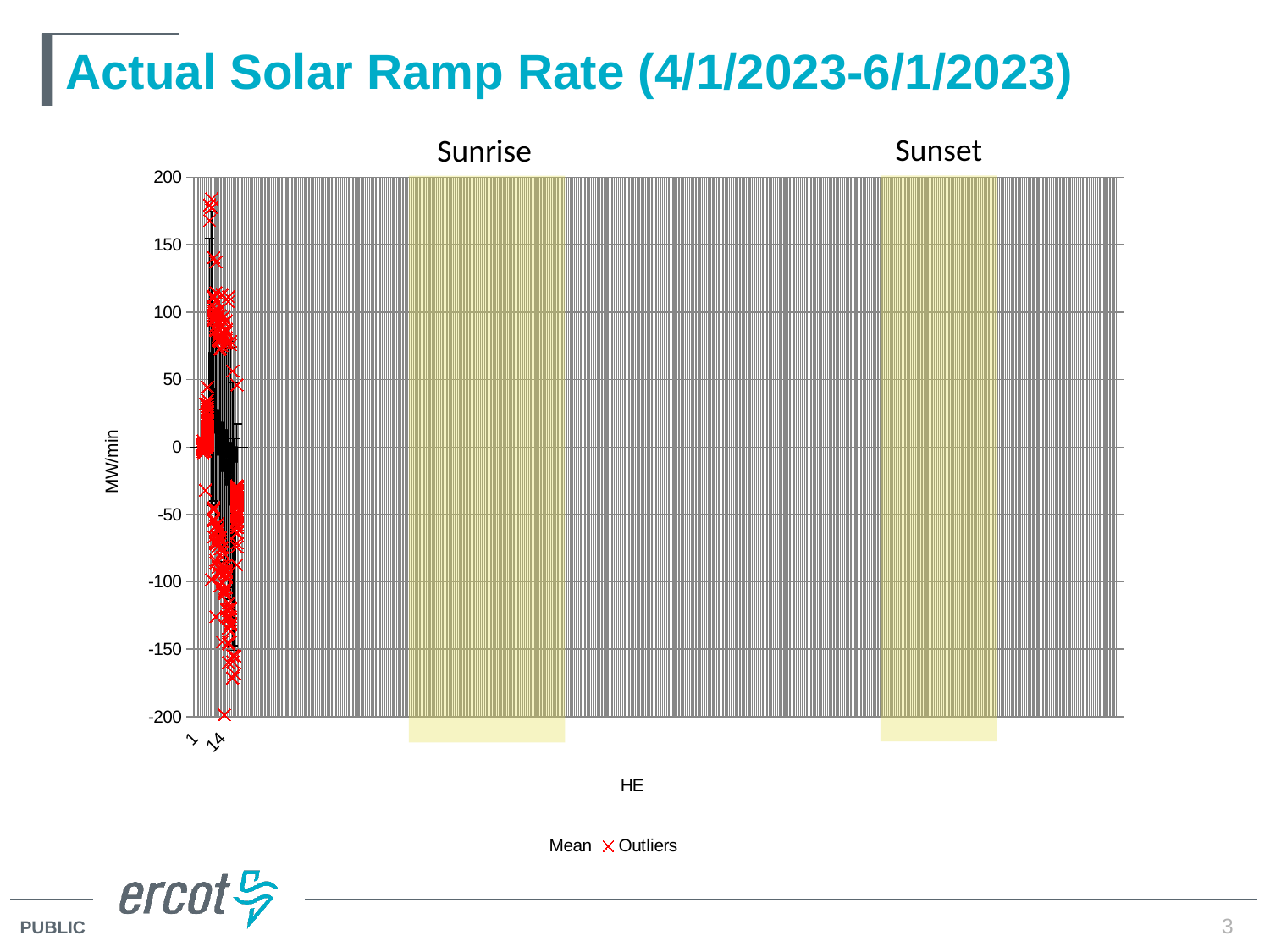
What unit is shown on the y-axis of the chart? MW/min Is the highest outlier value plotted on the chart greater or less than 150? greater How many series does the chart's legend list? 2 Is the highest outlier value plotted on the chart greater or less than 200? less Is the lowest outlier value plotted on the chart greater or less than -150? less What is the title of the chart on the slide? Actual Solar Ramp Rate (4/1/2023-6/1/2023)